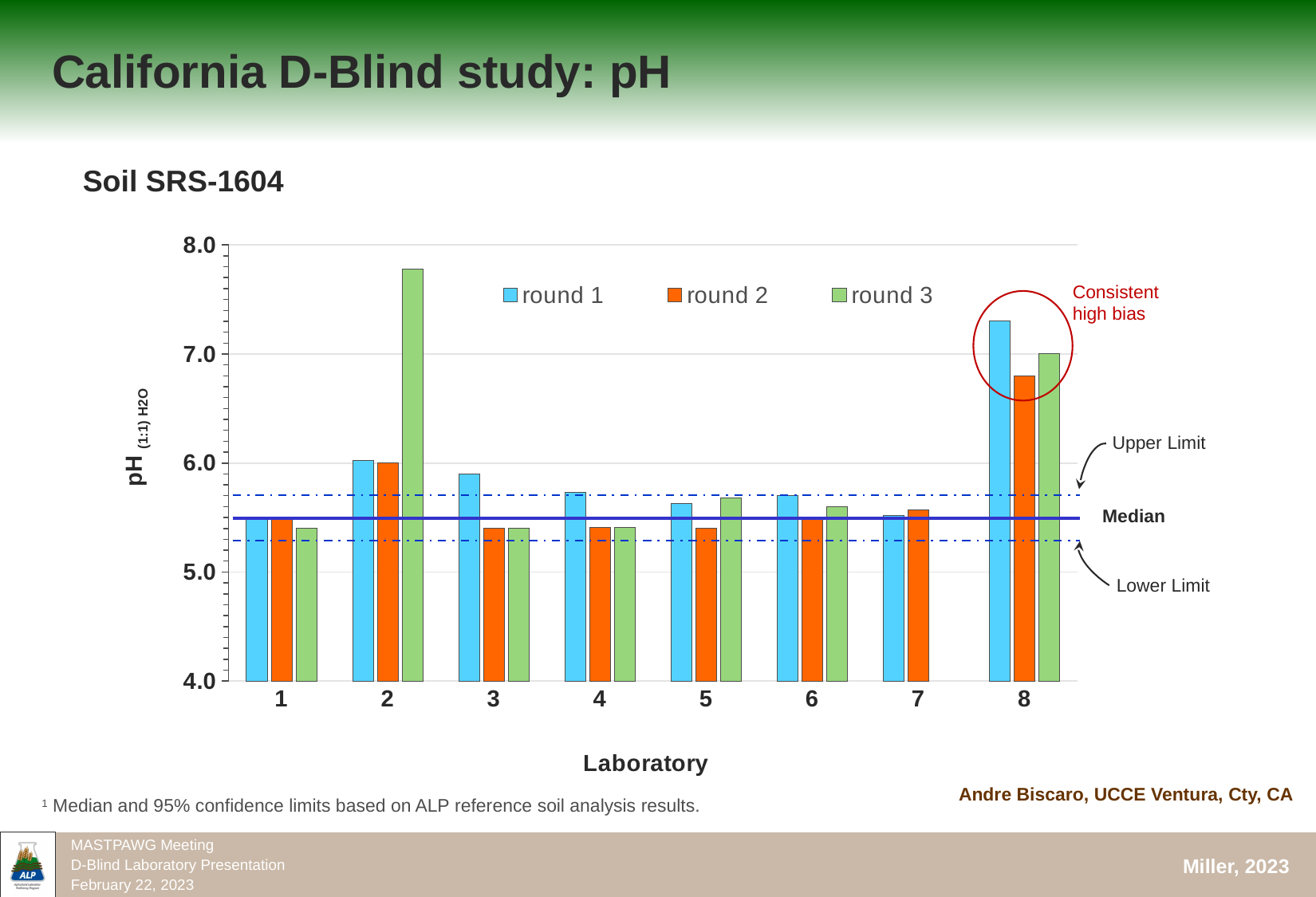
How many laboratories are shown on the x axis? 8 Which is larger: the round 1 pH value for Laboratory 8 or the round 2 pH value for Laboratory 8? round 1 Is the round 1 pH value for Laboratory 8 greater or less than 7.0? greater Which laboratory has the highest round 2 pH value? Laboratory 8 Which laboratory is circled and labelled as showing a consistent high bias? Laboratory 8 What kind of chart is shown on the slide? bar chart Is the round 1 pH value for Laboratory 3 greater or less than 6.0? less How many series does the chart legend list? 3 Which laboratory and round has the highest pH bar on the chart? Laboratory 2, round 3 Which laboratory has no round 3 bar plotted? Laboratory 7 Is the round 3 pH value for Laboratory 2 greater or less than 7.0? greater Which laboratory has the highest round 1 pH value? Laboratory 8